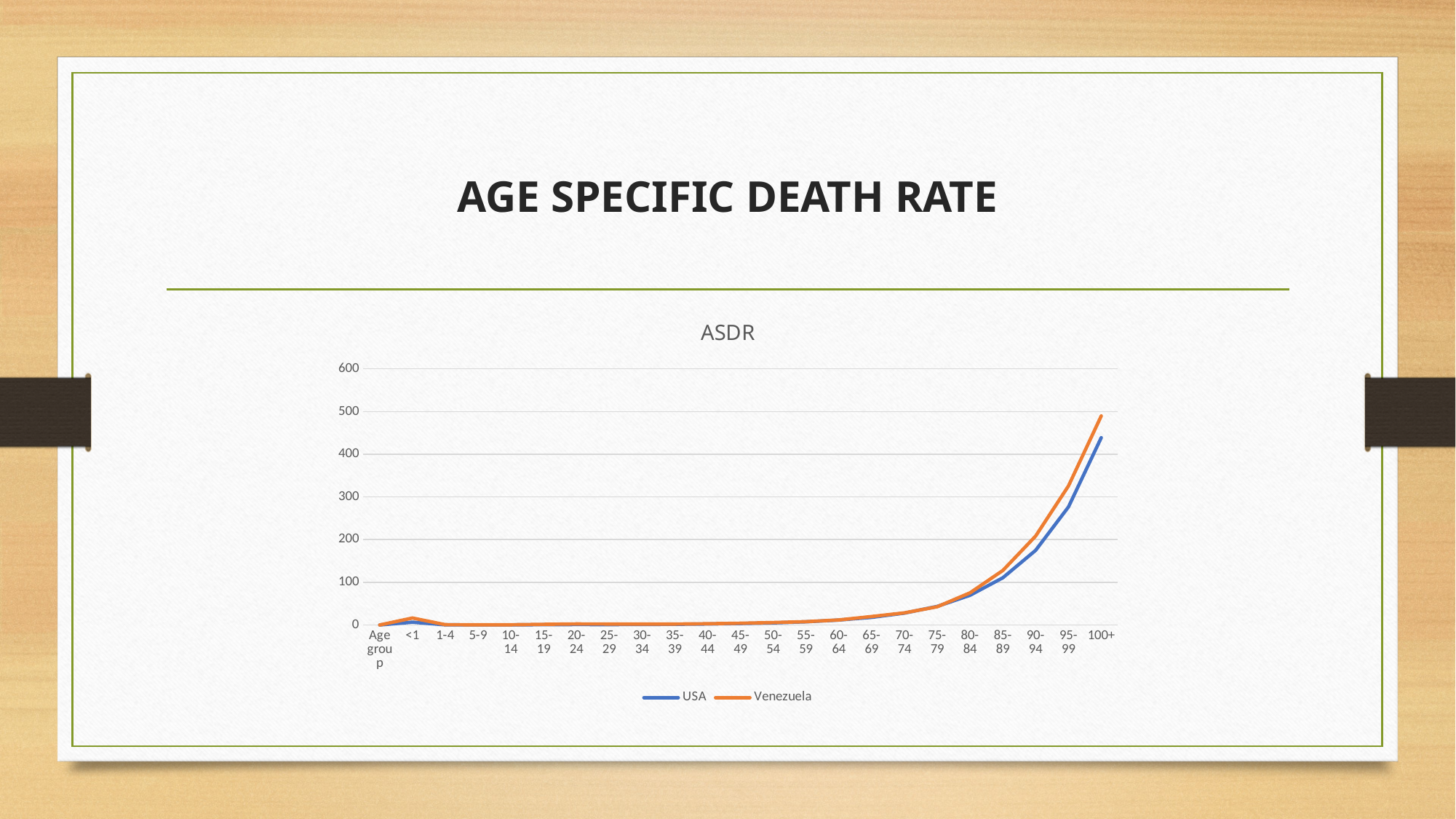
Is the USA value for 95-99 greater or less than 300? less Do the values generally rise or fall as the age groups move from 60-64 to 100+? rise What kind of chart is shown on the slide? line chart Is the Venezuela value for 85-89 greater or less than 200? less Which series are listed in the legend? USA and Venezuela Is the Venezuela value for 100+ greater or less than 400? greater What is the title of the chart? ASDR For which age group is the Venezuela value highest? 100+ How many series does the legend list? 2 For which age group is the USA value highest? 100+ At the 100+ age group, which series has the larger value, USA or Venezuela? Venezuela